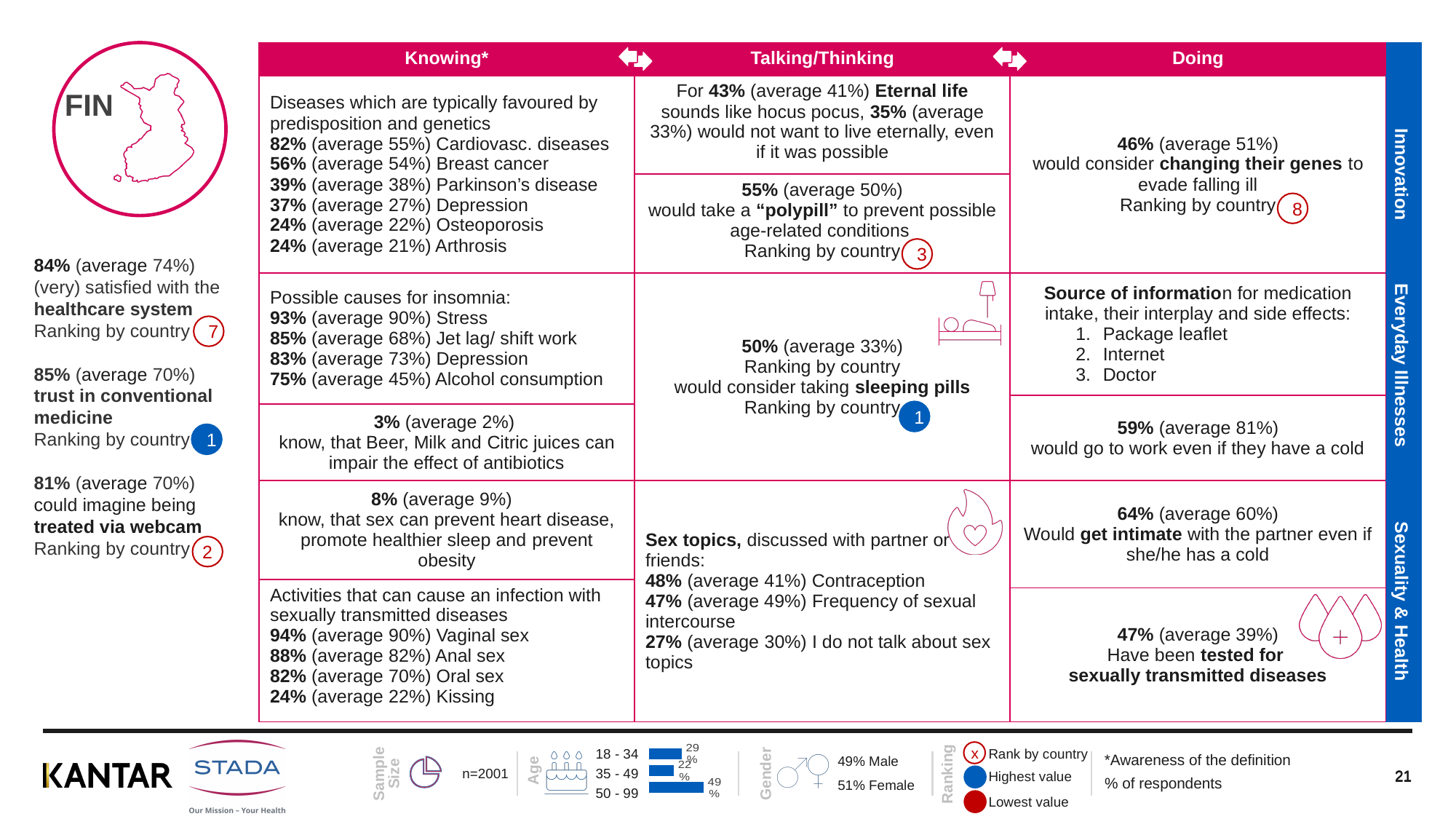
In the Age bar chart at the bottom of the slide, what is the difference between the values for 18 - 34 and 35 - 49? 7% In the Age bar chart at the bottom of the slide, which age group has the highest value? 50 - 99 What kind of chart is the Age chart at the bottom of the slide? bar chart How many age groups are shown in the Age bar chart at the bottom of the slide? 3 In the Age bar chart at the bottom of the slide, what is the value for the 50 - 99 age group? 49% In the Age bar chart at the bottom of the slide, what is the value for the 35 - 49 age group? 22% What is the sample size (n) shown next to the Sample Size chart at the bottom of the slide? n=2001 In the Age bar chart at the bottom of the slide, what is the value for the 18 - 34 age group? 29% In the Age bar chart at the bottom of the slide, which age group has the larger value, 18 - 34 or 35 - 49? 18 - 34 In the Age bar chart at the bottom of the slide, what is the difference between the values for 50 - 99 and 18 - 34? 20% In the Age bar chart at the bottom of the slide, which age group has the lowest value? 35 - 49 What is the label of the age group listed first (at the top) in the Age bar chart at the bottom of the slide? 18 - 34